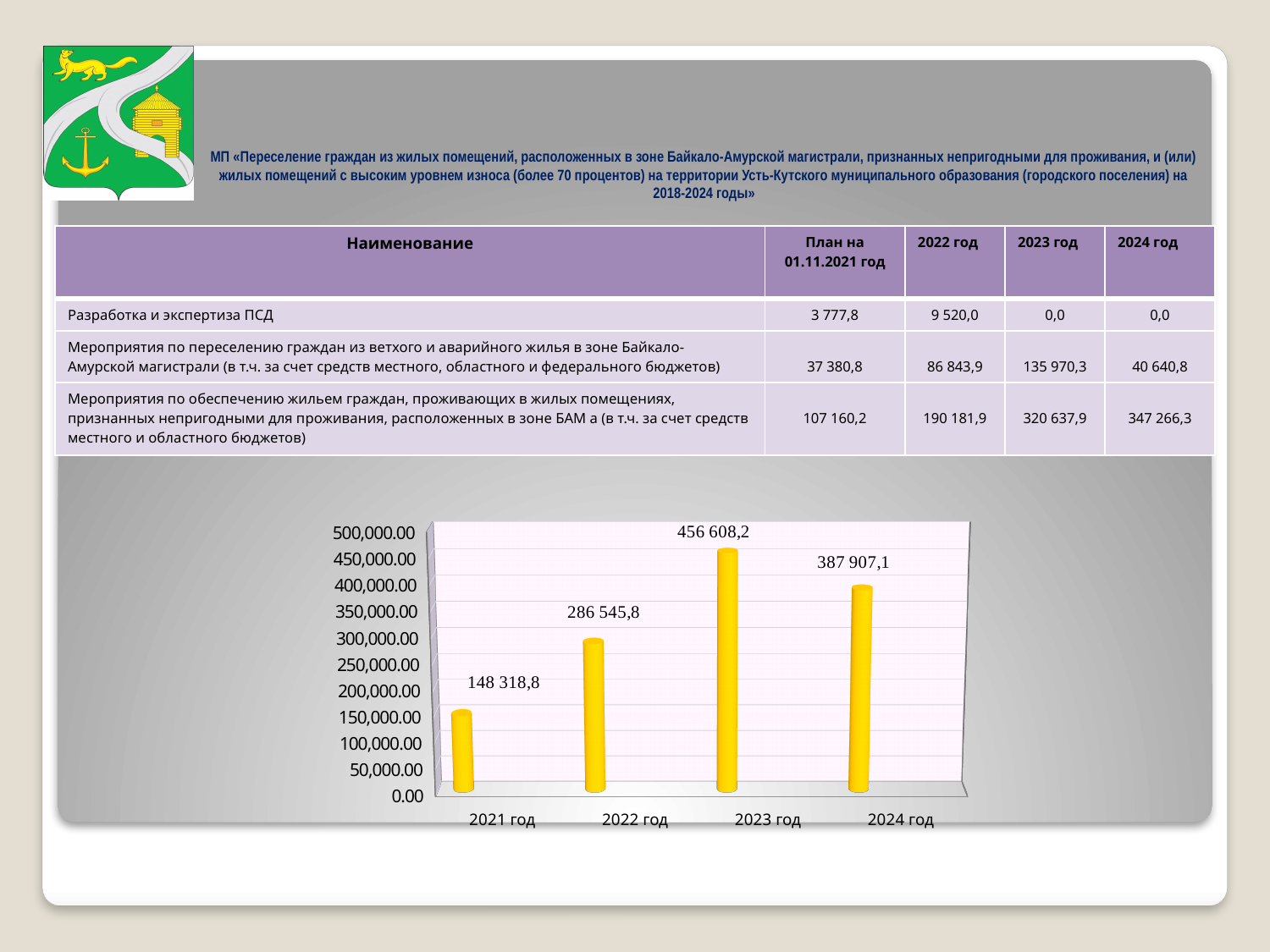
What is the difference between the values for 2022 год and 2021 год in the bar chart? 138 227,0 Which year has the highest value in the bar chart? 2023 год What is the difference between the values for 2023 год and 2024 год in the bar chart? 68 701,1 Which year has the lowest value in the bar chart? 2021 год What is the highest value marked on the vertical axis of the bar chart? 500,000.00 How many years (categories) are shown in the bar chart? 4 Is the value for 2022 год in the bar chart greater or less than 300,000.00? less What is the value shown for 2021 год in the bar chart? 148 318,8 What is the value shown for 2024 год in the bar chart? 387 907,1 What is the value shown for 2023 год in the bar chart? 456 608,2 What kind of chart is shown on the slide? bar chart Which is larger in the bar chart, the value for 2022 год or the value for 2024 год? 2024 год